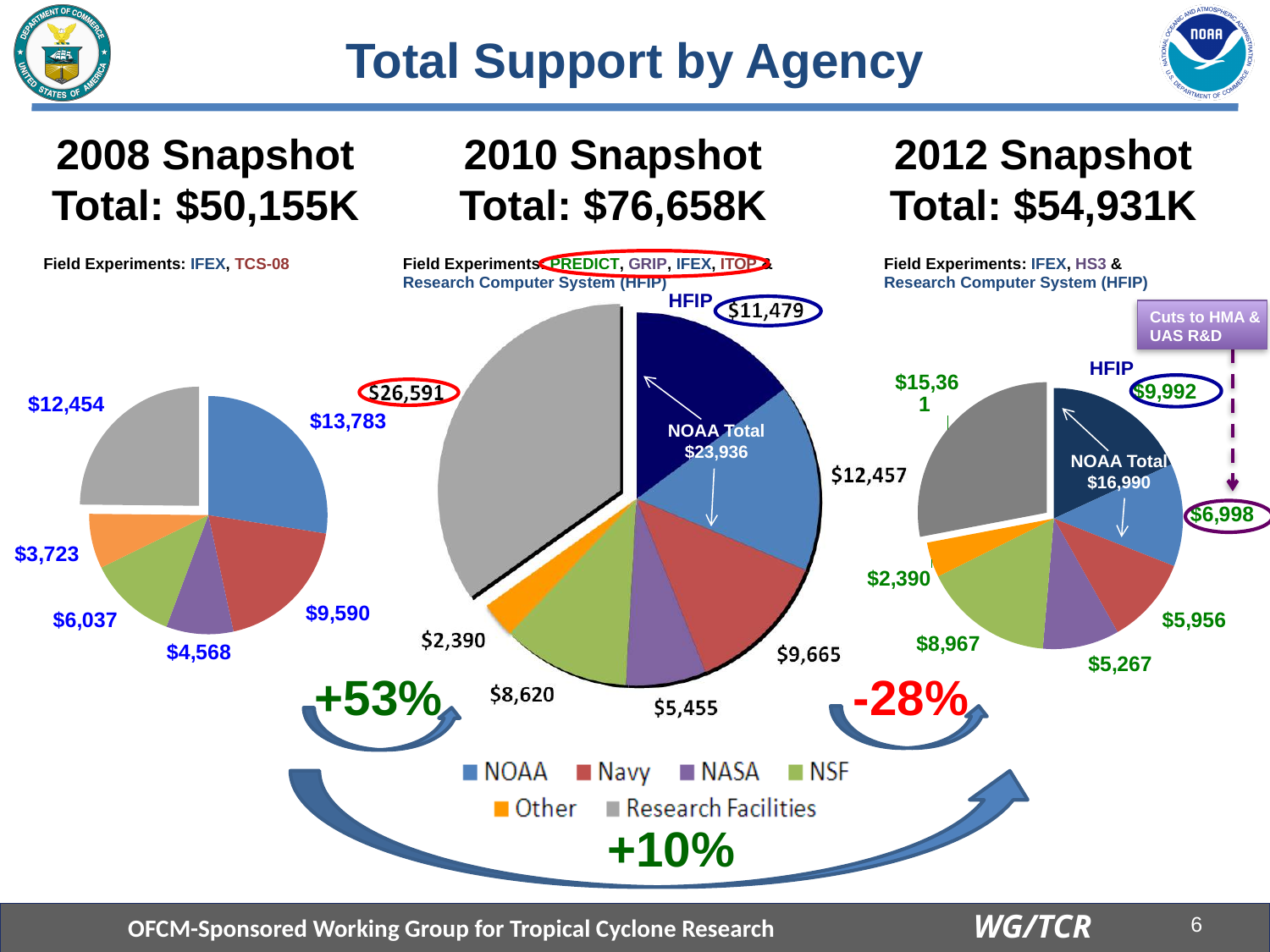
In the 2012 Snapshot pie chart, what is the value for HFIP? $9,992 In the 2008 Snapshot pie chart, what is the value for Navy? $9,590 In the 2010 Snapshot pie chart, what is the value for Research Facilities? $26,591 In the 2008 Snapshot pie chart, what is the value for Research Facilities? $12,454 What is the total shown for the 2010 Snapshot? $76,658K How many series does the shared legend list? 6 In the 2010 Snapshot pie chart, what is the difference between the NSF value and the NASA value? $3,165 What is the title of the slide? Total Support by Agency What kind of charts are shown on the slide? Pie charts In the 2010 Snapshot pie chart, what is the NOAA Total shown? $23,936 In the 2008 Snapshot pie chart, which agency has the smallest slice? Other In the 2012 Snapshot pie chart, which is larger, the NSF value or the Navy value? NSF